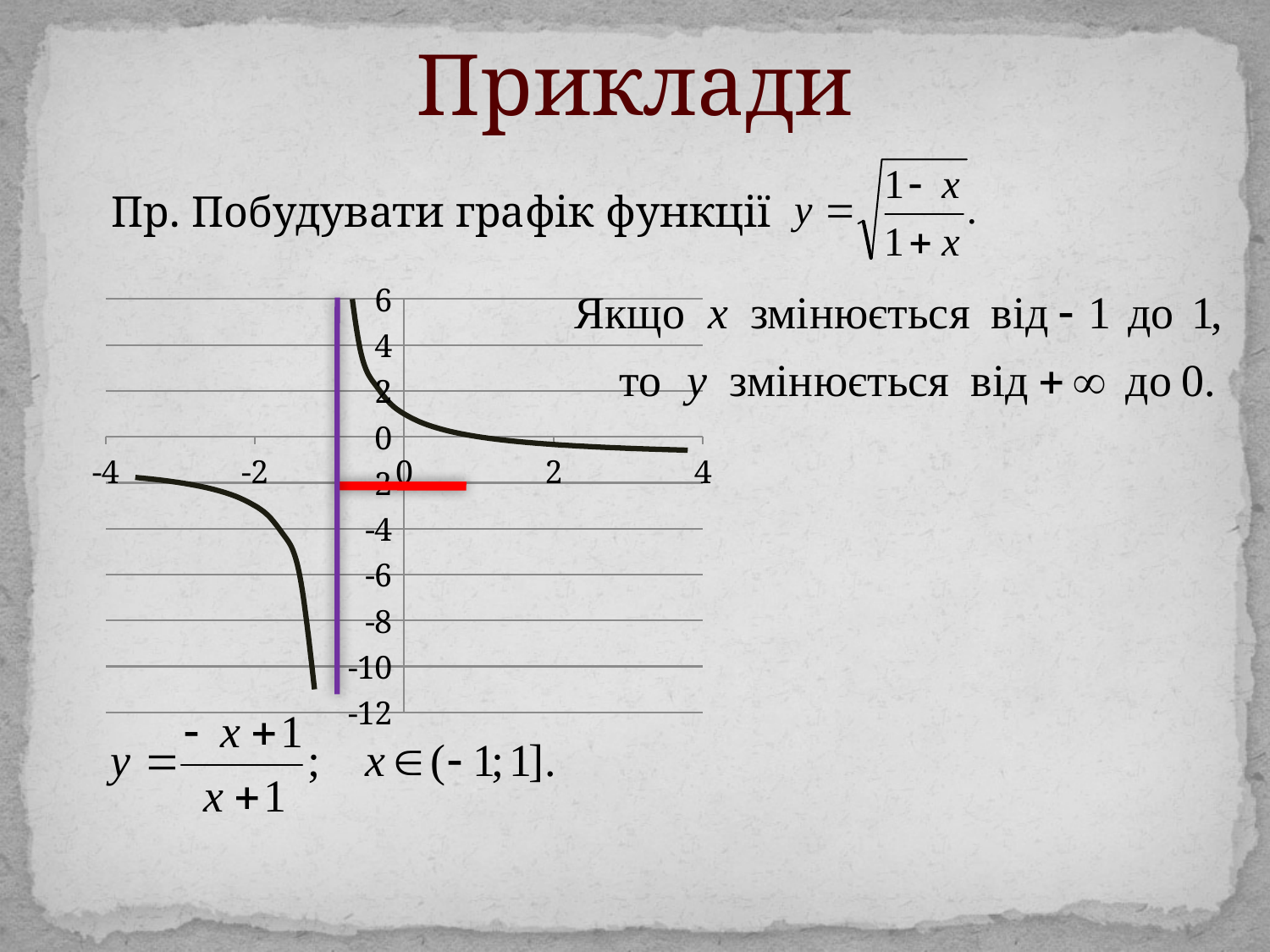
How many separate branches does the plotted curve have? 2 As x increases from 0 to 4, does the curve rise or fall? fall What is the lowest value labelled on the vertical axis of the chart? -12 As x increases from -4 toward -1, does the curve rise or fall? fall What is the highest value labelled on the vertical axis of the chart? 6 How many tick labels are shown on the horizontal axis of the chart? 5 What kind of chart is shown on the slide? line chart Is the value of the curve at x = 2 greater or less than -2? greater Is the value of the curve at x = 2 greater or less than 2? less Which is larger, the value of the curve at x = 2 or at x = -2? x = 2 Is the value of the curve at x = -2 greater or less than 0? less